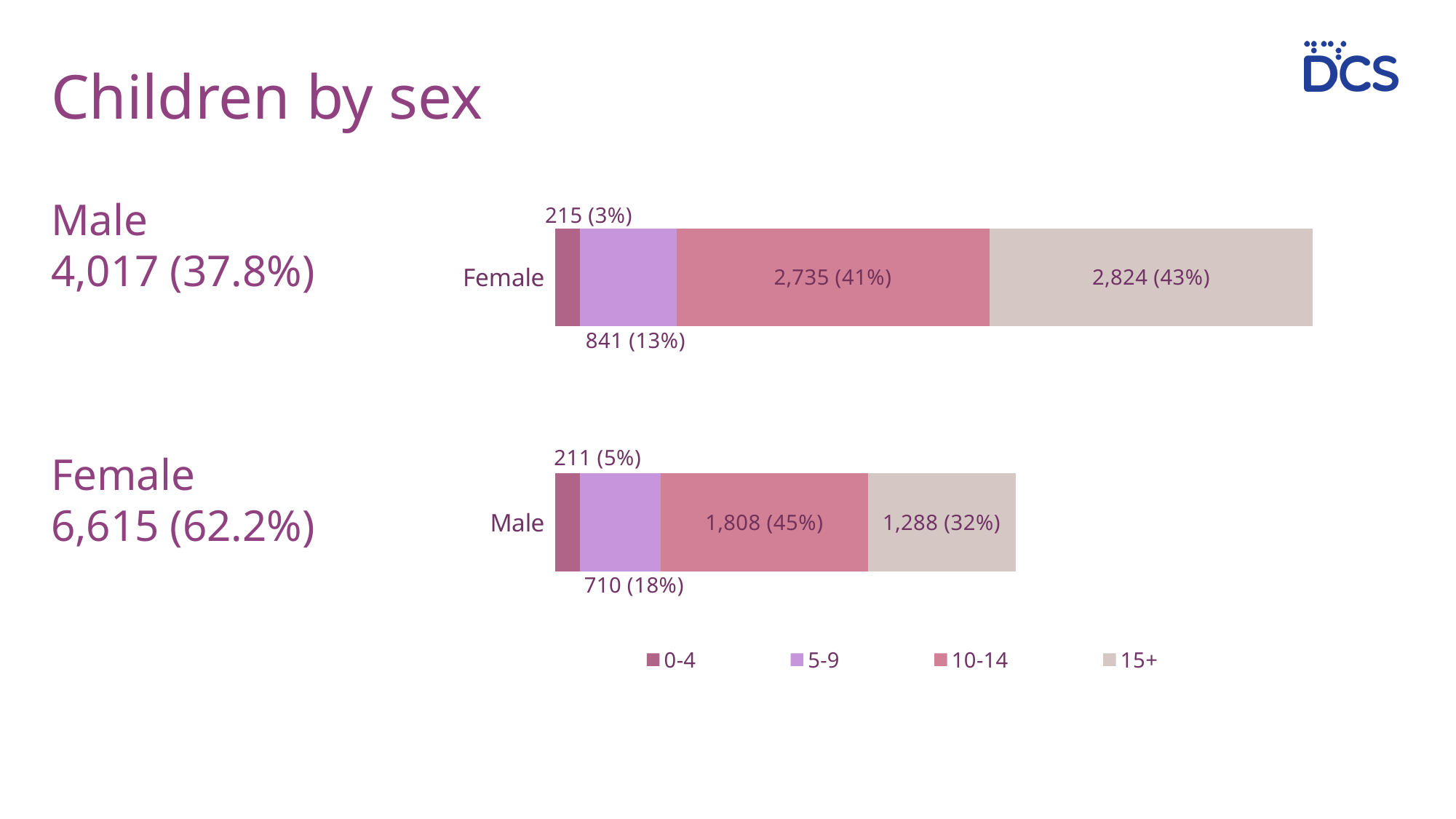
What is the difference between the 10-14 values for Female and Male? 927 Which is larger, the 15+ value for Female or the 15+ value for Male? Female How many categories (bars) are plotted in the chart? 2 What is the value for the 0-4 age group in the Male bar? 211 (5%) How many series does the legend list? 4 What is the value for the 5-9 age group in the Female bar? 841 (13%) Which age group has the largest value in the Female bar? 15+ What is the total of the Male stacked bar? 4,017 What kind of chart is shown on the slide? Stacked bar chart What is the value for the 10-14 age group in the Female bar? 2,735 (41%) Which age group has the smallest value in the Male bar? 0-4 What is the value for the 15+ age group in the Male bar? 1,288 (32%)